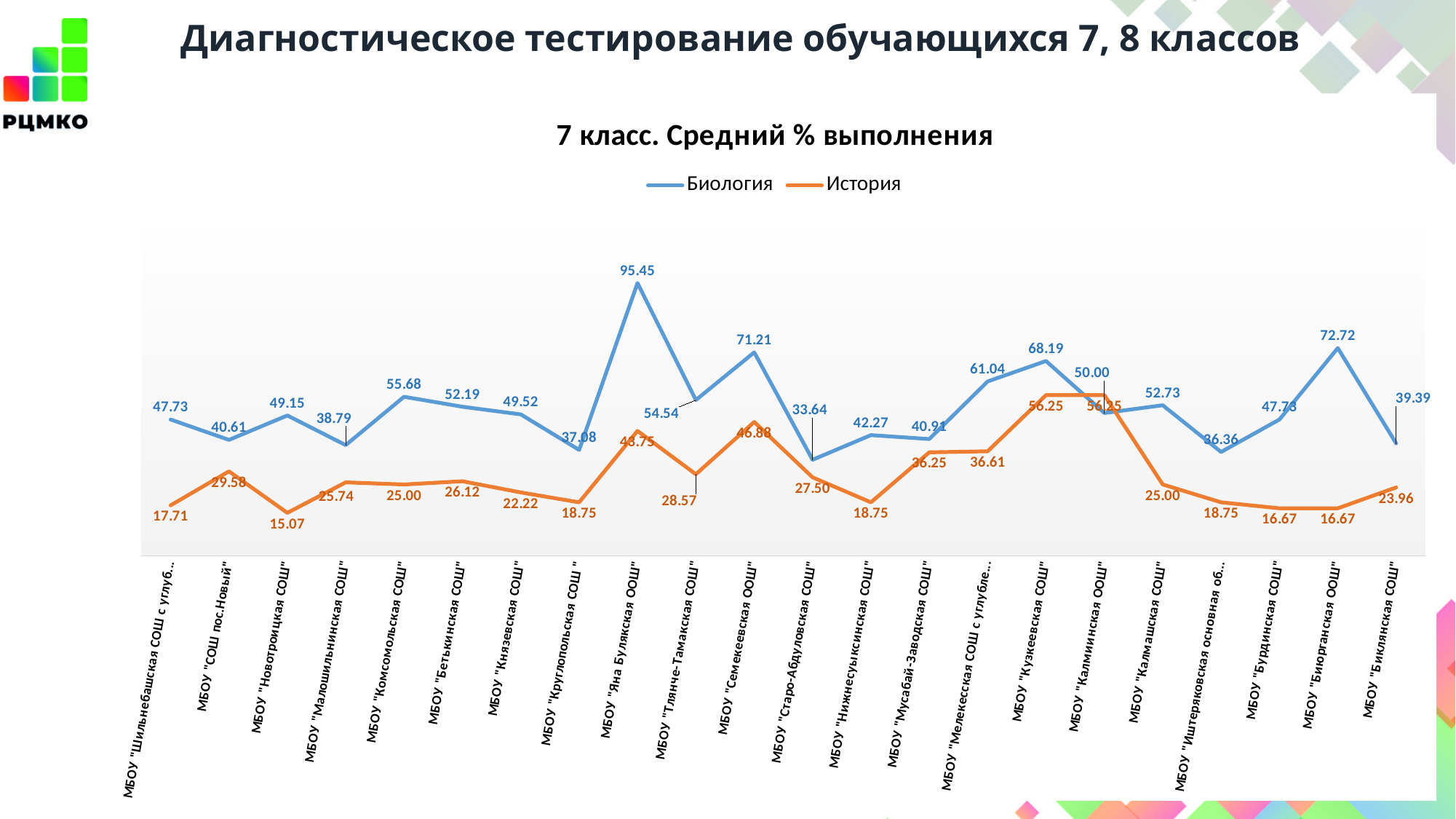
Which is larger: the Биология value for МБОУ "Комсомольская СОШ" or for МБОУ "Бетькинская СОШ"? МБОУ "Комсомольская СОШ" Which school has the lowest История value? МБОУ "Новотроицкая СОШ" Which school has the lowest Биология value? МБОУ "Старо-Абдуловская СОШ" What is the История value for МБОУ "Семекеевская ООШ"? 46.88 How many series does the legend list? 2 How many schools (categories) are plotted along the x axis? 22 What is the title of the chart? 7 класс. Средний % выполнения Which school has the highest Биология value? МБОУ "Яна Булякская ООШ" What is the Биология value for МБОУ "Яна Булякская ООШ"? 95.45 What is the Биология value for МБОУ "Калмиинская ООШ"? 50.00 What is the difference between the Биология and История values for МБОУ "Яна Булякская ООШ"? 51.70 What type of chart is shown on the slide? Line chart